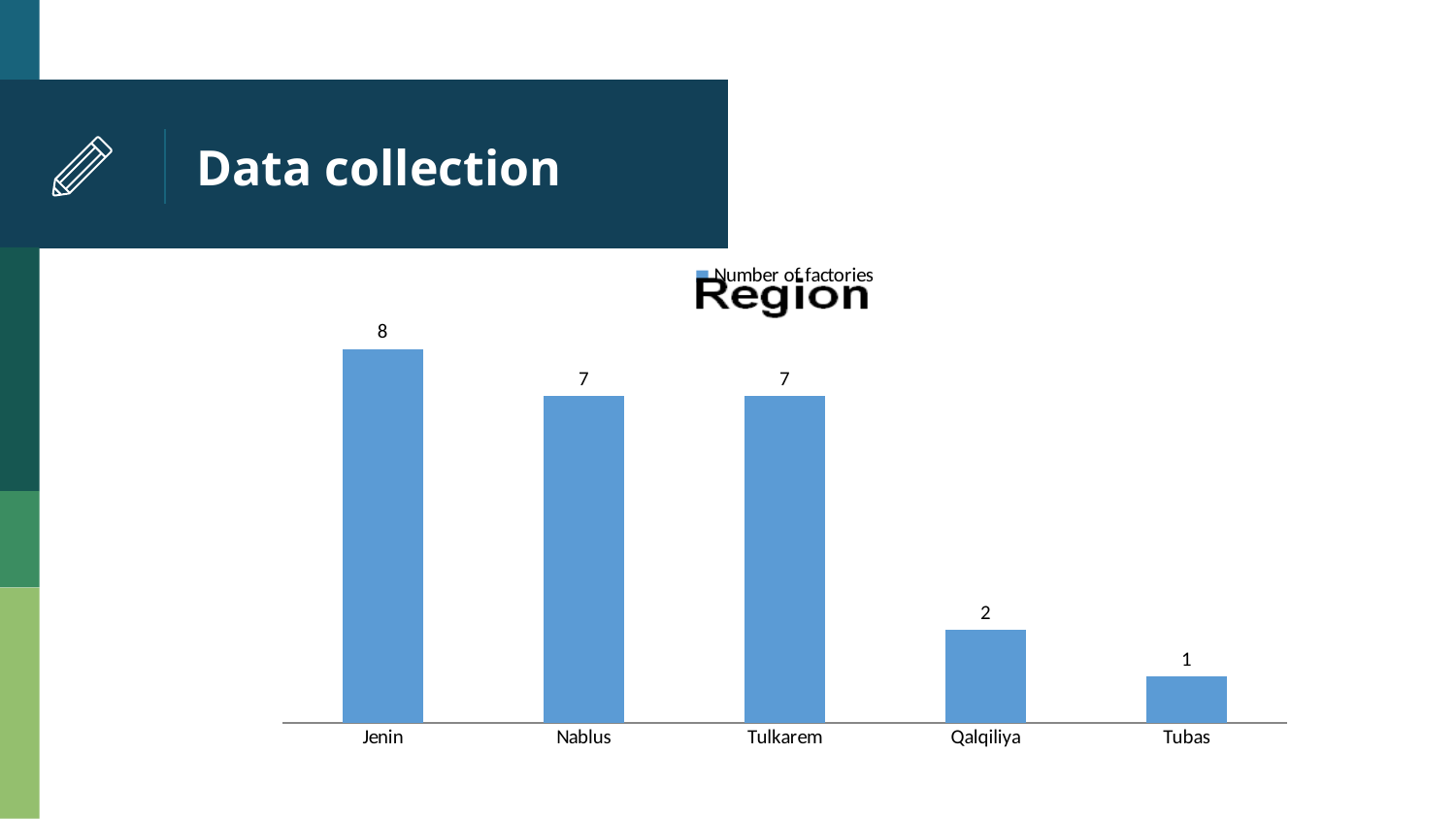
What is the number of factories for Nablus? 7 What series does the chart legend list? Number of factories What is the difference in the number of factories between Jenin and Qalqiliya? 6 Which region has the highest number of factories? Jenin Which region has the lowest number of factories? Tubas What is the difference in the number of factories between Tulkarem and Tubas? 6 What is the number of factories for Jenin? 8 Which has more factories, Nablus or Qalqiliya? Nablus What kind of chart is shown on the slide? Bar chart What is the number of factories for Qalqiliya? 2 How many regions are shown on the chart? 5 What is the number of factories for Tubas? 1